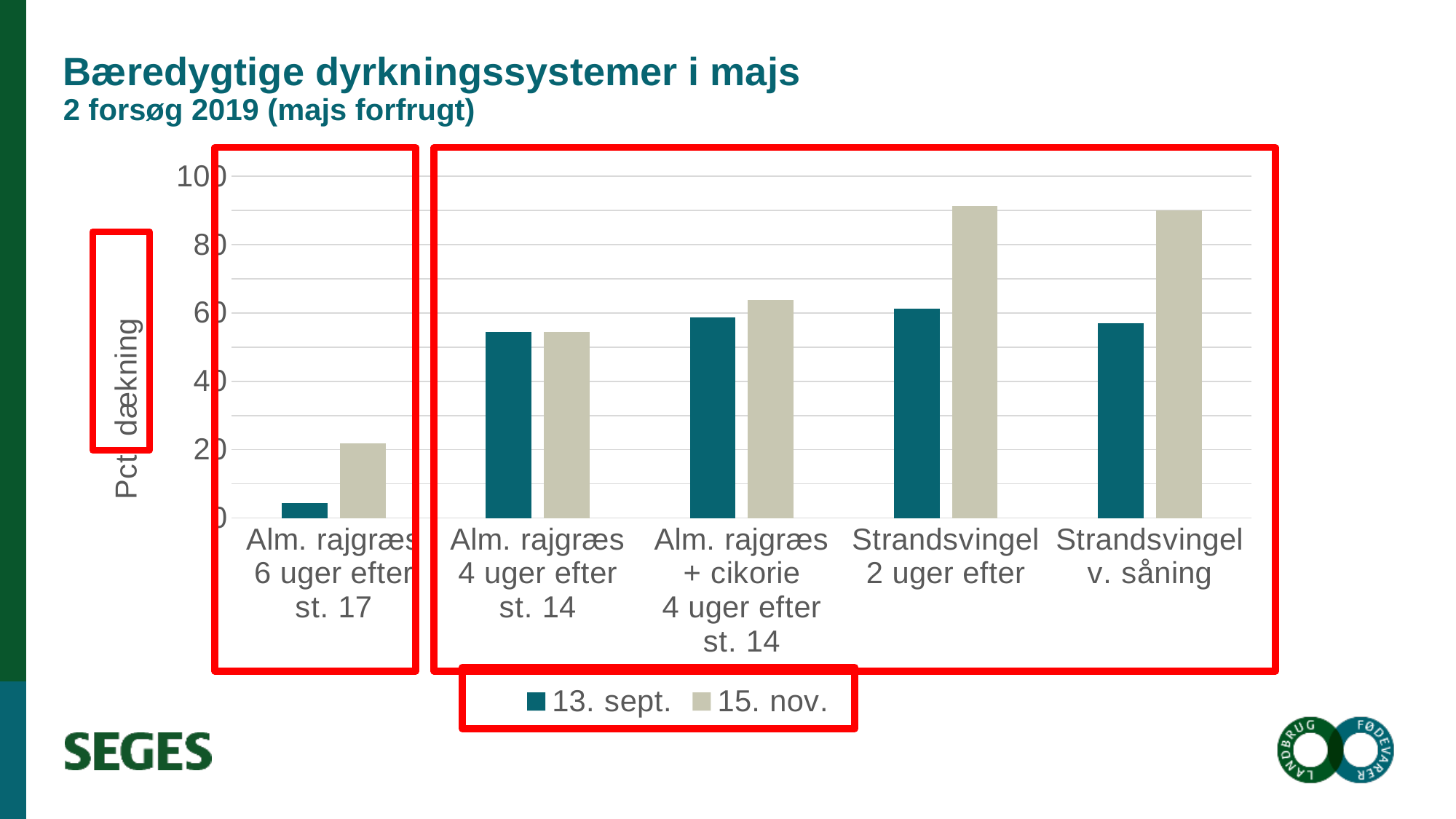
What kind of chart is shown on the slide? bar chart Is the 13. sept. value for Alm. rajgræs 6 uger efter st. 17 greater or less than 20? less Which category has the lowest value for the 15. nov. series? Alm. rajgræs 6 uger efter st. 17 What are the two series named in the chart's legend? 13. sept. and 15. nov. For Strandsvingel 2 uger efter, which series has the larger value, 13. sept. or 15. nov.? 15. nov. What is the label on the chart's y axis? Pct. dækning For Alm. rajgræs 6 uger efter st. 17, which series has the larger value, 13. sept. or 15. nov.? 15. nov. Is the 15. nov. value for Strandsvingel v. såning greater or less than 80? greater How many series does the chart's legend list? 2 How many categories are shown on the x axis of the chart? 5 Is the 13. sept. value for Alm. rajgræs 4 uger efter st. 14 greater or less than 60? less Which category has the lowest value for the 13. sept. series? Alm. rajgræs 6 uger efter st. 17